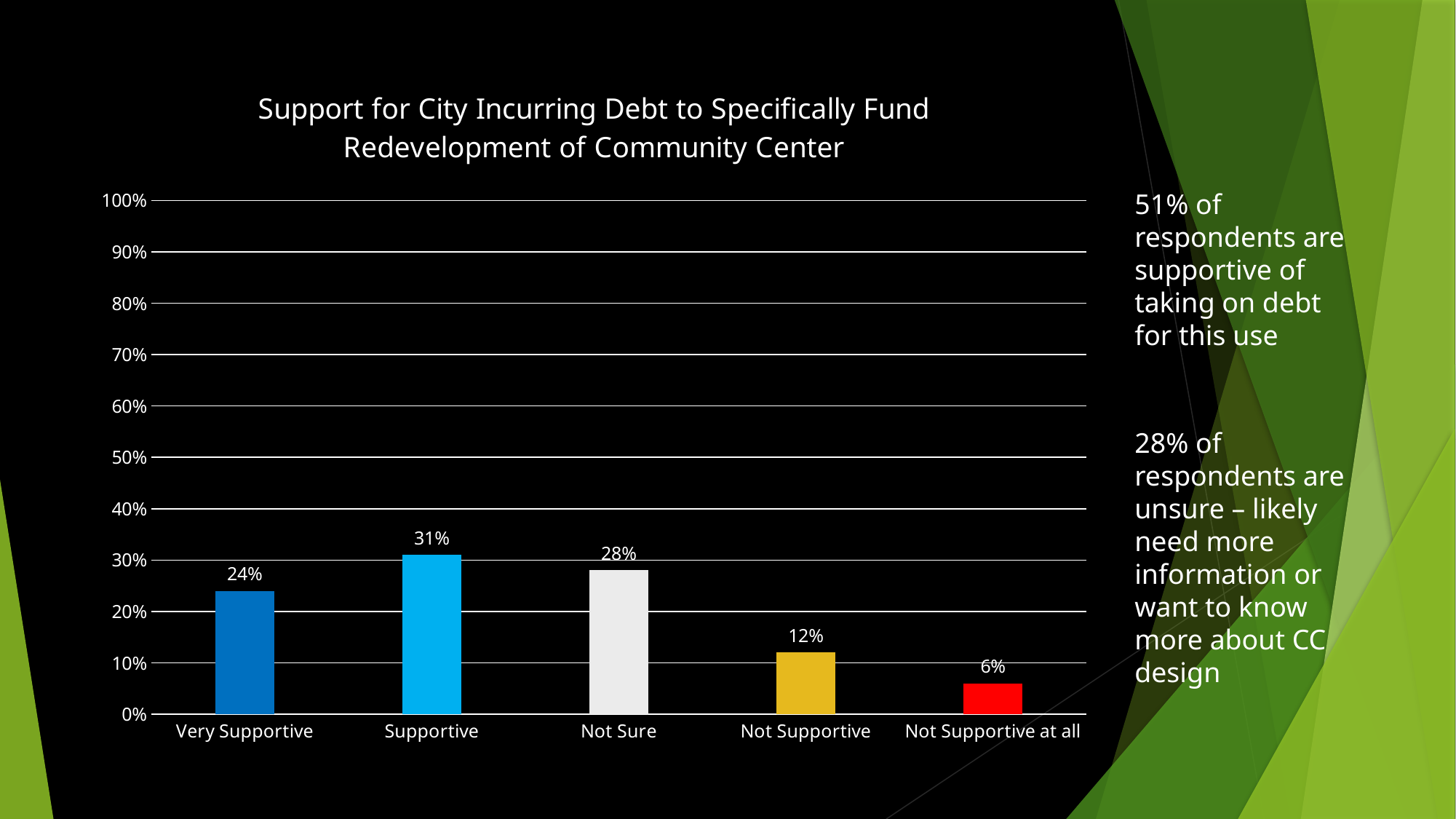
Which category has the lowest value? Not Supportive at all What percentage of respondents are Very Supportive? 24% How many categories are shown on the x axis? 5 What is the difference between the Not Sure and Not Supportive values? 16% What is the difference between the Supportive and Very Supportive values? 7% What is the title of the chart? Support for City Incurring Debt to Specifically Fund Redevelopment of Community Center Which category has the highest value? Supportive Is the value for Supportive greater or less than 40%? less What kind of chart is shown on the slide? bar chart What percentage of respondents are Not Supportive at all? 6% Which is larger, the value for Not Sure or the value for Very Supportive? Not Sure What is the value for the Not Sure category? 28%